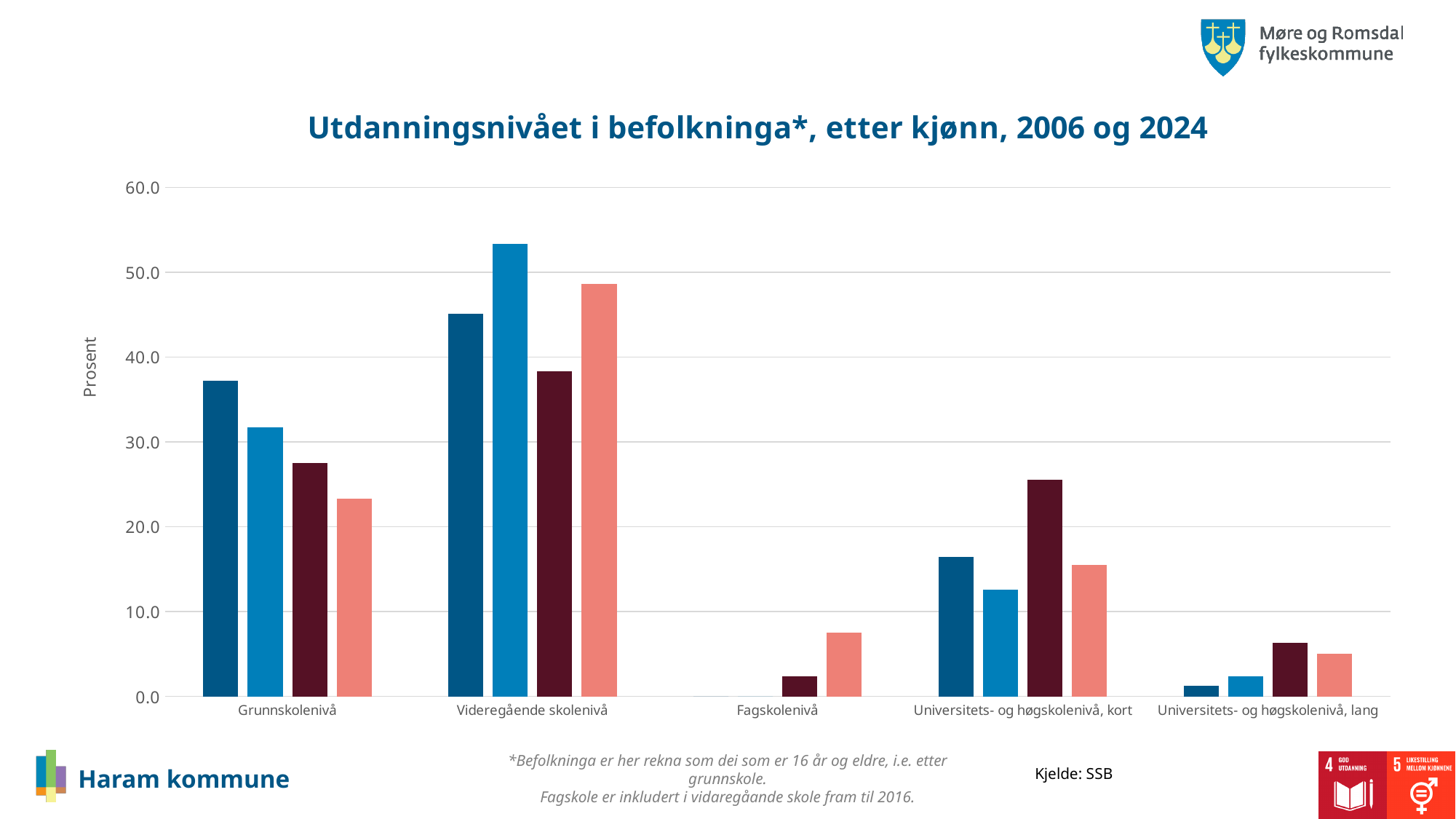
What is the title of the chart? Utdanningsnivået i befolkninga*, etter kjønn, 2006 og 2024 Is the value of the dark red (third) bar for Universitets- og høgskolenivå, kort greater or less than 20? greater Is the value of the dark blue (first) bar for Universitets- og høgskolenivå, lang greater or less than 10? less Is the value of the light blue (second) bar for Videregående skolenivå greater or less than 50? greater What source is cited below the chart? SSB For Videregående skolenivå, which is larger: the light blue (second) bar or the dark red (third) bar? the light blue (second) bar What kind of chart is shown on the slide? bar chart Which category has the tallest bars in the chart? Videregående skolenivå How many education-level categories are shown on the x axis? 5 For Grunnskolenivå, which is larger: the dark blue (first) bar or the salmon (last) bar? the dark blue (first) bar